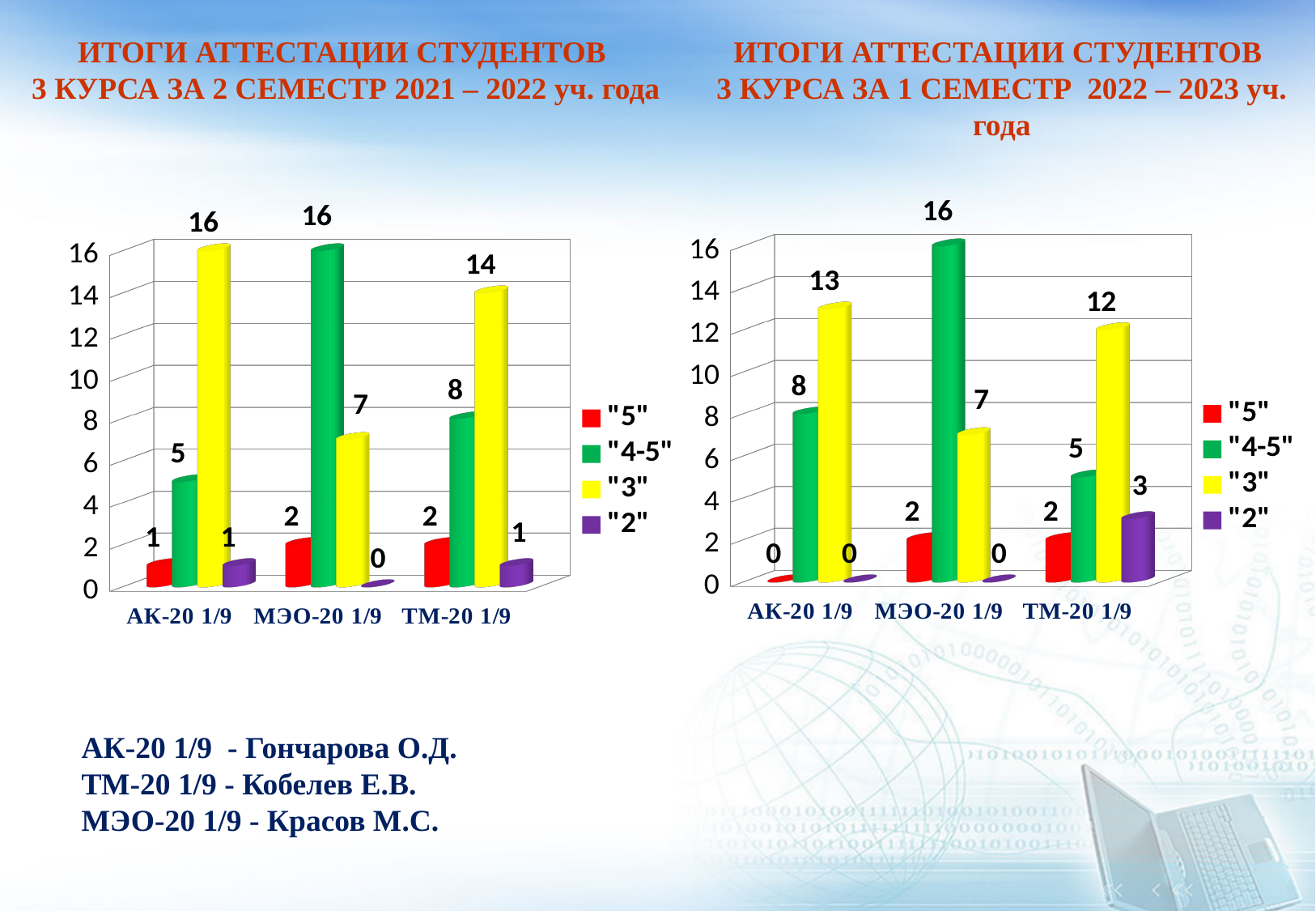
In the left chart, which category has the highest value for "4-5"? МЭО-20 1/9 In the left chart, what is the value for "3" for АК-20 1/9? 16 In the right chart, what is the total of all four series for ТМ-20 1/9? 22 In the right chart, which is larger: the "4-5" value for АК-20 1/9 or for ТМ-20 1/9? АК-20 1/9 How many series does the legend of the right chart list? 4 In the right chart, what is the value for "4-5" for МЭО-20 1/9? 16 In the right chart, what is the value for "2" for ТМ-20 1/9? 3 How many categories are shown on the x axis of the left chart? 3 In the left chart, what is the difference between the "3" values for АК-20 1/9 and ТМ-20 1/9? 2 In the right chart, which category has the lowest value for "3"? МЭО-20 1/9 In the left chart, which colour represents the "2" series? purple What type of chart is the left chart? bar chart